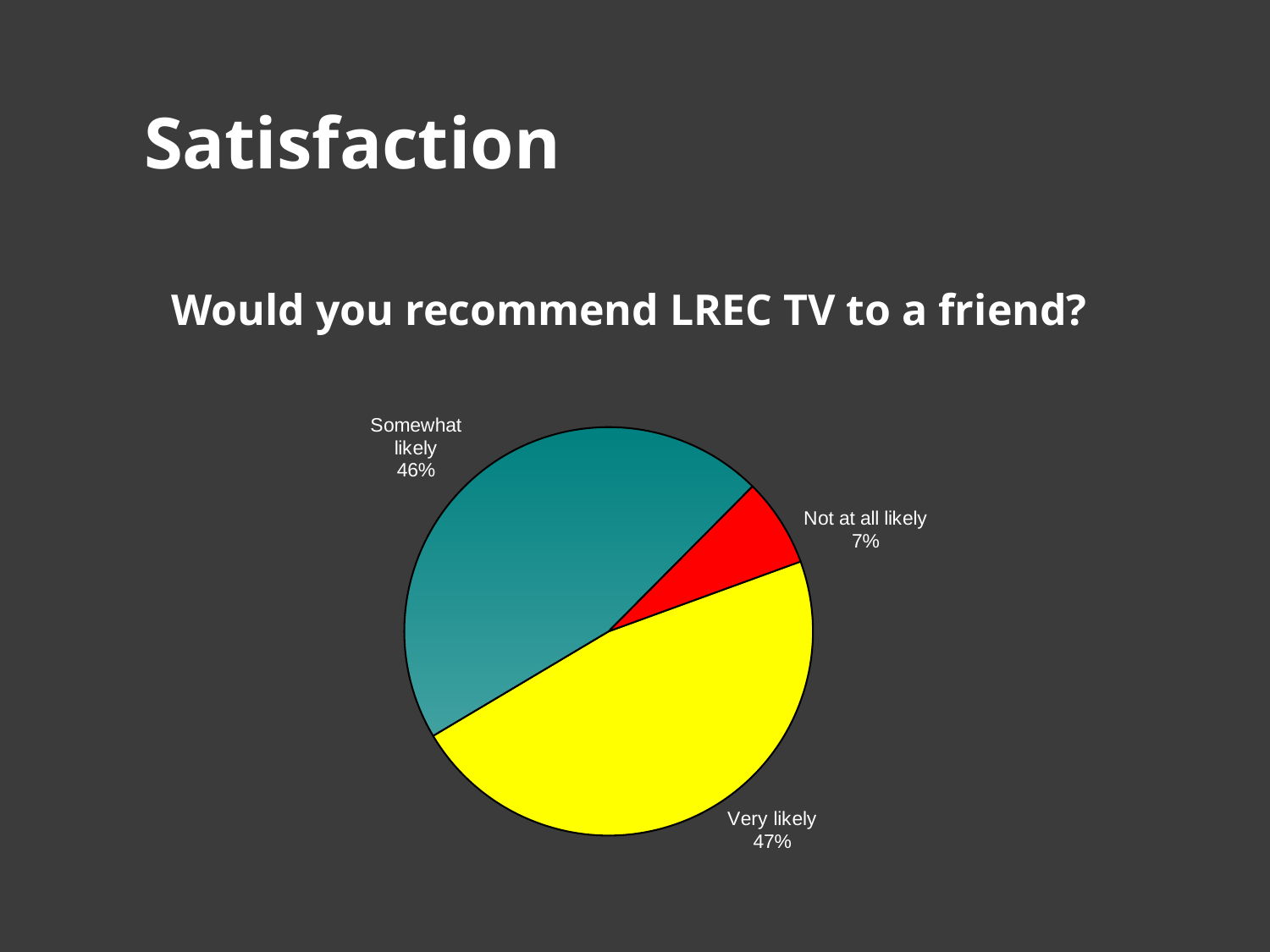
Which is larger, the Somewhat likely slice or the Not at all likely slice? Somewhat likely What share of respondents said they are very likely to recommend LREC TV to a friend? 47% What is the difference in percentage points between the Somewhat likely and Not at all likely slices? 39 What colour is the Very likely slice? yellow What share of respondents said they are somewhat likely to recommend LREC TV? 46% How many slices does the pie chart have? 3 What question does the chart title ask? Would you recommend LREC TV to a friend? What is the difference in percentage points between the Very likely and Not at all likely slices? 40 What share of respondents said they are not at all likely to recommend LREC TV? 7% What kind of chart is shown on the slide? pie chart Which response category has the smallest slice of the pie? Not at all likely